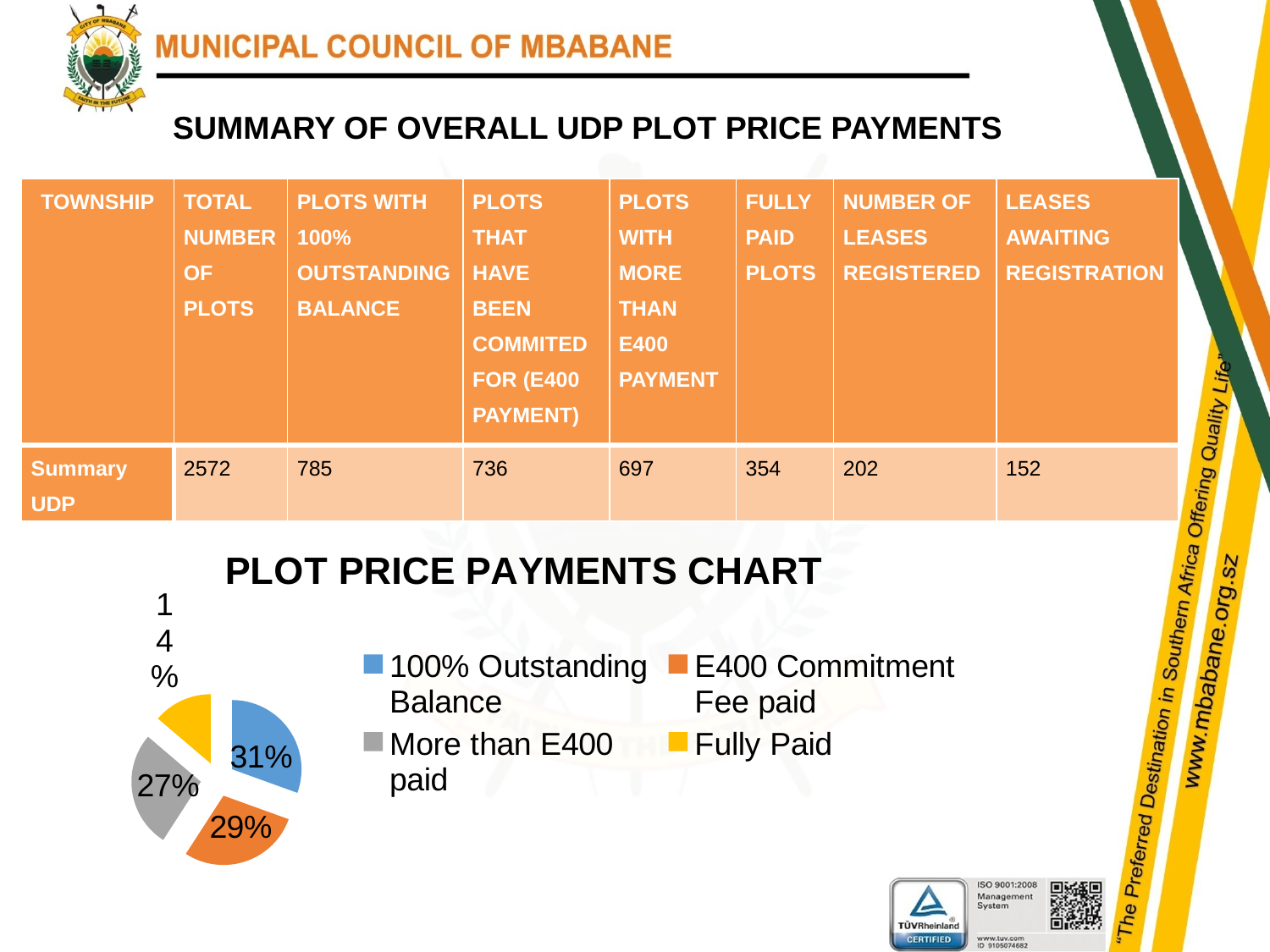
Which category has the largest slice in the pie chart? 100% Outstanding Balance Which category has the smallest slice in the pie chart? Fully Paid What type of chart is shown under the title "PLOT PRICE PAYMENTS CHART"? pie chart What colour is the "Fully Paid" slice in the pie chart? yellow What is the title of the chart on the slide? PLOT PRICE PAYMENTS CHART What is the difference in percentage points between the "100% Outstanding Balance" slice and the "Fully Paid" slice? 17 How many categories does the legend of the pie chart list? 4 What percentage of the pie chart is labelled for "Fully Paid"? 14% What percentage of the pie chart is labelled for "More than E400 paid"? 27% What percentage of the pie chart is labelled for "100% Outstanding Balance"? 31% Which slice is larger in the pie chart: "E400 Commitment Fee paid" or "More than E400 paid"? E400 Commitment Fee paid What percentage of the pie chart is labelled for "E400 Commitment Fee paid"? 29%